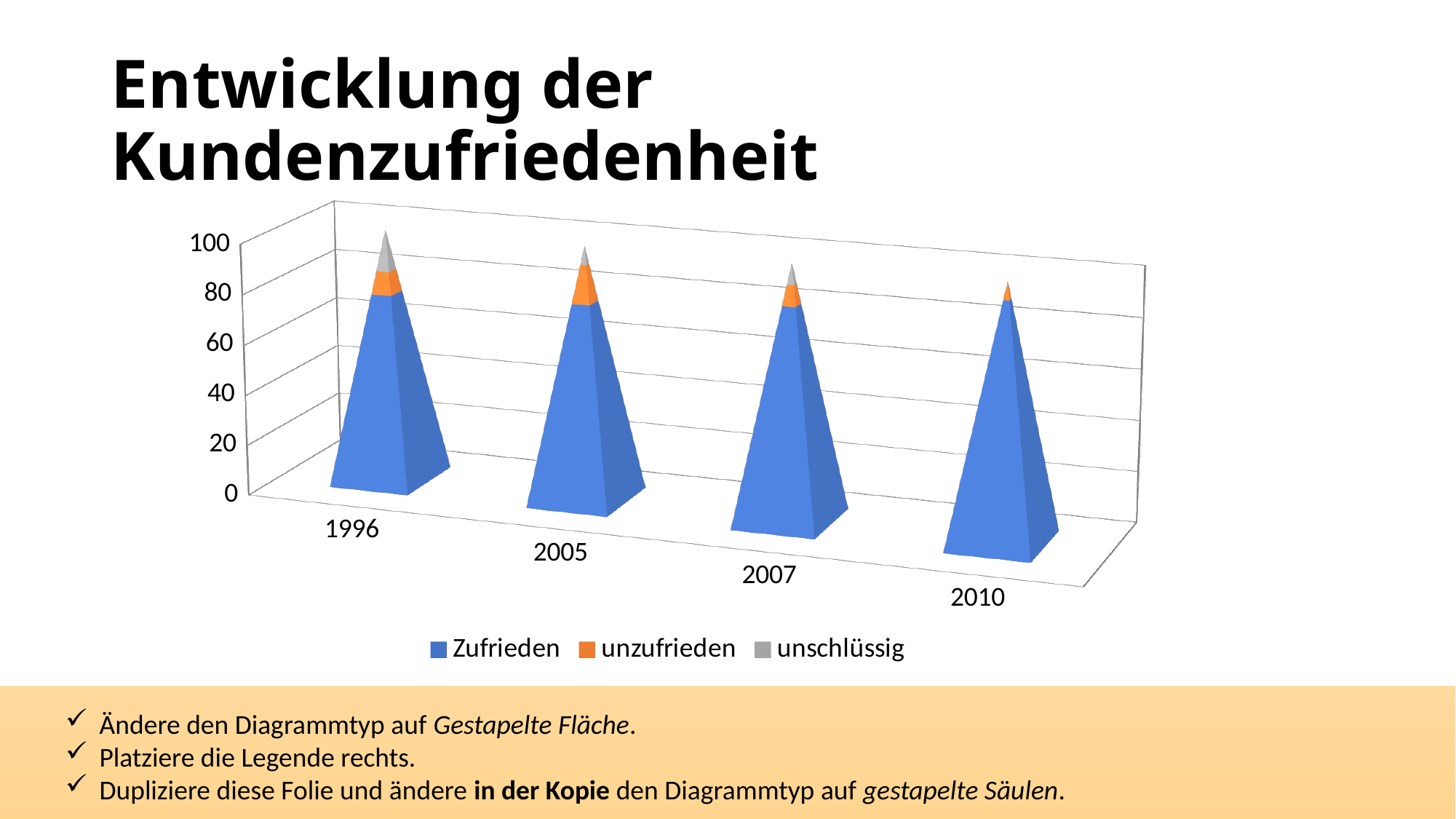
How many years are shown on the x axis of the chart? 4 In which year is the 'unschlüssig' segment the largest? 1996 Is the value for 'Zufrieden' in 1996 greater or less than 60? greater What is the highest value shown on the vertical axis of the chart? 100 How many series does the chart legend list? 3 Which colour represents the series 'Zufrieden' in the chart? Blue Is the total of the stacked bar for 1996 greater or less than 80? greater What kind of chart is shown on the slide? Stacked bar chart What is the title of the slide containing the chart? Entwicklung der Kundenzufriedenheit In 2005, which is larger: the 'Zufrieden' segment or the 'unzufrieden' segment? Zufrieden In which year is the 'unschlüssig' segment the smallest? 2010 Is the value for 'unzufrieden' in 1996 greater or less than 20? less